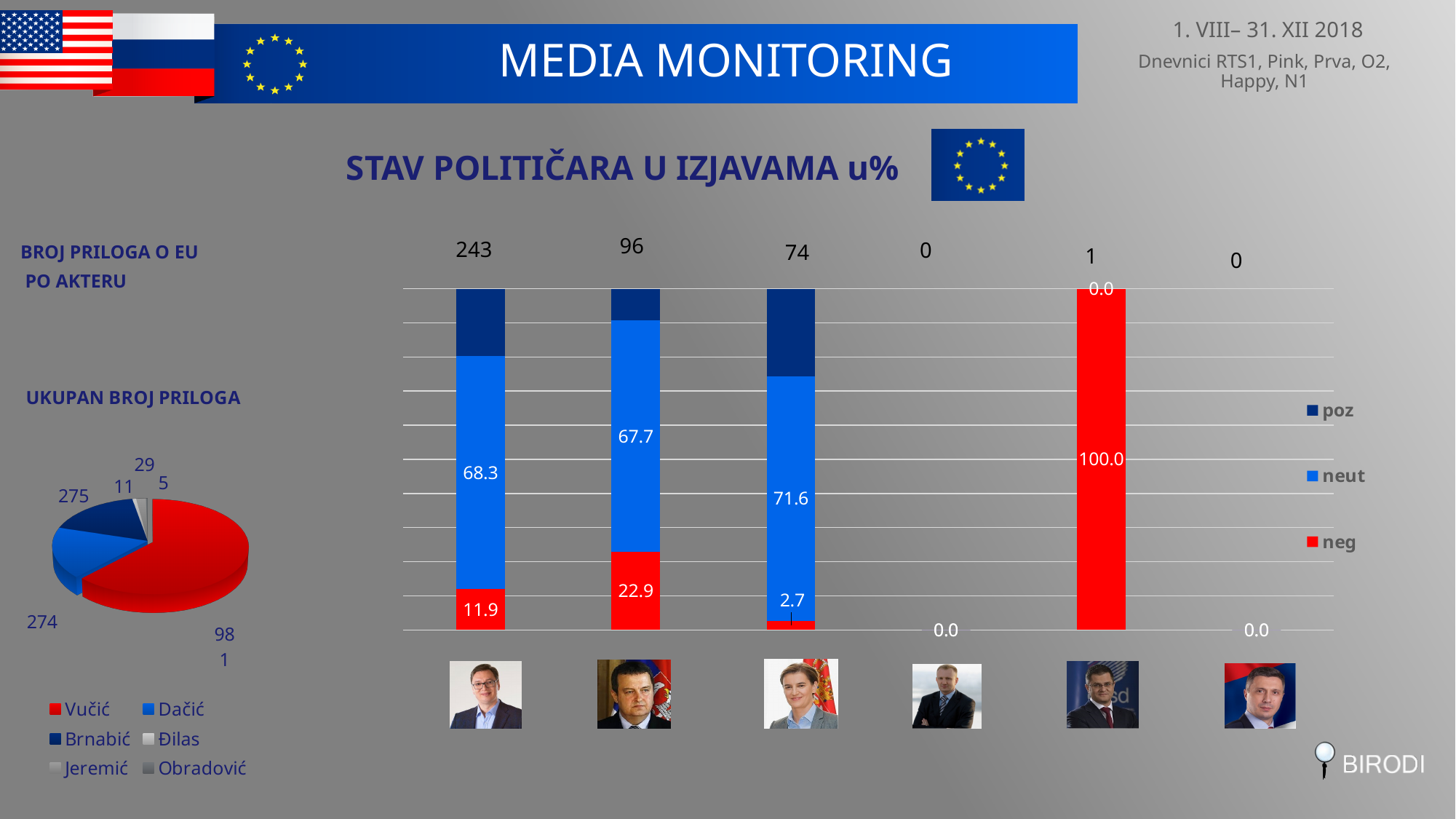
In the chart titled 'STAV POLITIČARA U IZJAVAMA u%', what is the 'neg' value for the third bar from the left? 2.7 In the chart titled 'STAV POLITIČARA U IZJAVAMA u%', how many bars are plotted? 6 In the chart titled 'STAV POLITIČARA U IZJAVAMA u%', what is the 'neut' value for the first bar from the left? 68.3 In the chart titled 'STAV POLITIČARA U IZJAVAMA u%', what is the 'neg' value for the fifth bar from the left? 100.0 In the chart titled 'STAV POLITIČARA U IZJAVAMA u%', which has the larger 'neg' value, the first bar or the second bar from the left? The second bar What kind of chart is the chart titled 'STAV POLITIČARA U IZJAVAMA u%'? Stacked bar chart In the chart titled 'STAV POLITIČARA U IZJAVAMA u%', what is the 'neg' value for the second bar from the left? 22.9 What kind of chart is the chart titled 'UKUPAN BROJ PRILOGA'? Pie chart In the chart titled 'STAV POLITIČARA U IZJAVAMA u%', what is the difference between the 'neg' values of the second and first bars from the left? 11.0 In the chart titled 'STAV POLITIČARA U IZJAVAMA u%', how many series does the legend list? 3 In the pie chart titled 'UKUPAN BROJ PRILOGA', which legend entry has the largest slice? Vučić In the chart titled 'STAV POLITIČARA U IZJAVAMA u%', which bar has the highest 'neg' value? The fifth bar from the left